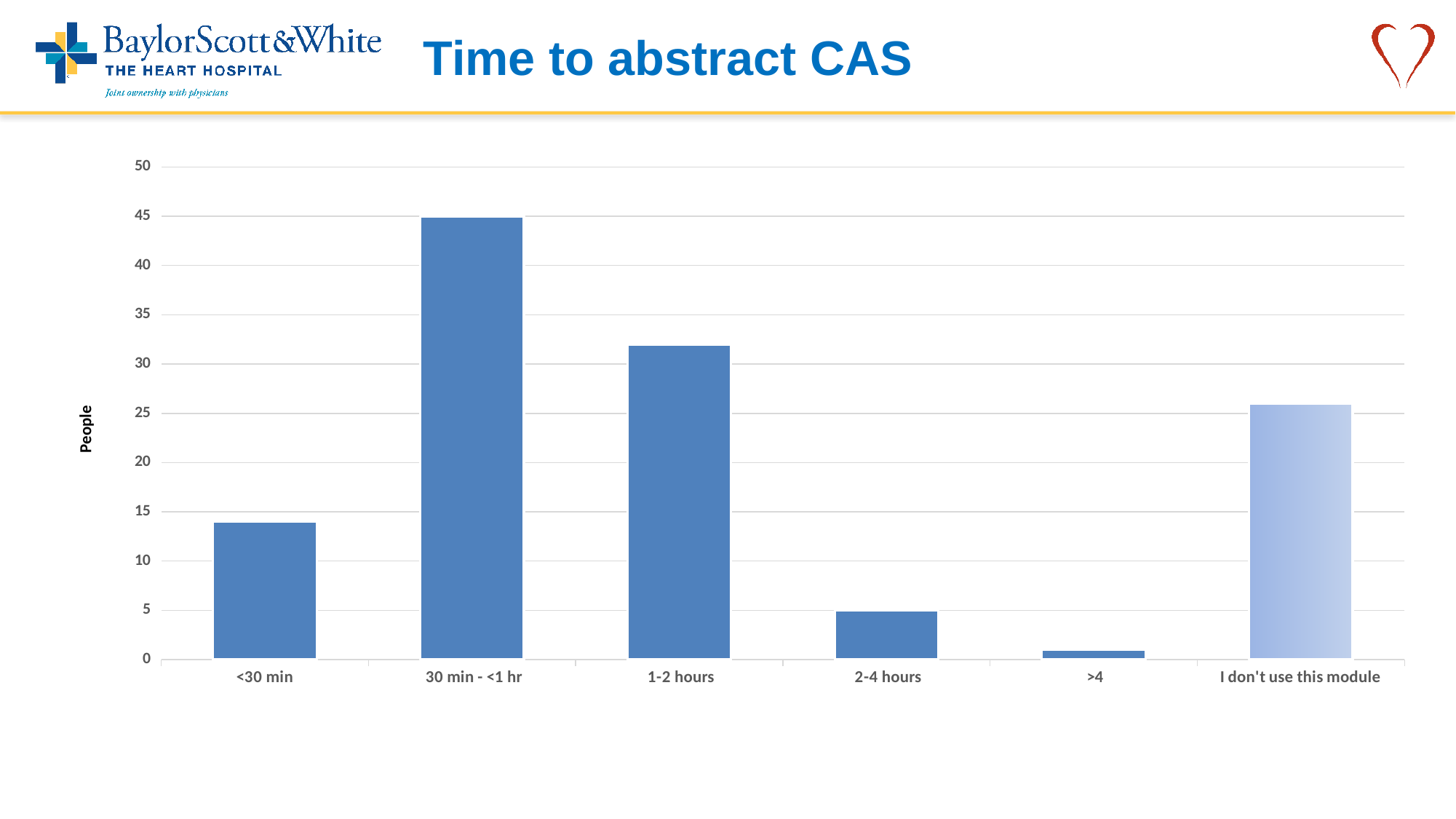
Is the value for 30 min - <1 hr greater or less than 40? greater What is the label on the vertical axis? People Which is larger, the value for 1-2 hours or the value for I don't use this module? 1-2 hours How many categories are shown on the x axis? 6 Which category has the lowest value? >4 Is the value for 2-4 hours greater or less than 10? less Is the value for <30 min greater or less than 10? greater Which is larger, the value for <30 min or the value for 2-4 hours? <30 min Which category has the highest value? 30 min - <1 hr What kind of chart is shown on the slide? bar chart